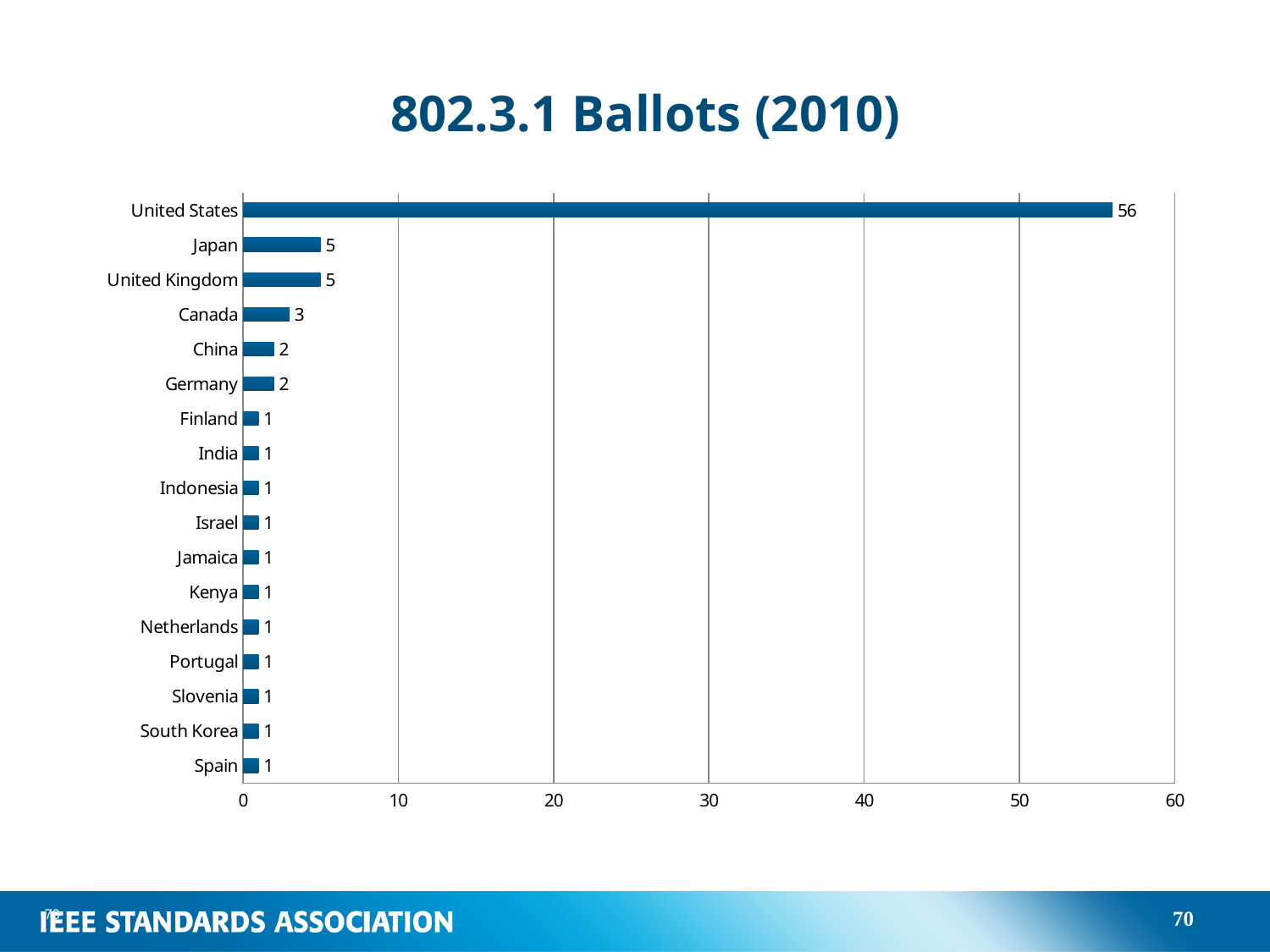
What is the value for United States? 56 Is the value for United States greater or less than 50? greater Which country has the highest value? United States What is the value for Canada? 3 What is the value for Germany? 2 What is the difference between the values for United States and Japan? 51 What is the value for Japan? 5 What is the title of the chart? 802.3.1 Ballots (2010) What is the difference between the values for Canada and China? 1 What kind of chart is shown on the slide? bar chart How many countries are shown in the chart? 17 Which is larger, the value for United Kingdom or the value for Canada? United Kingdom